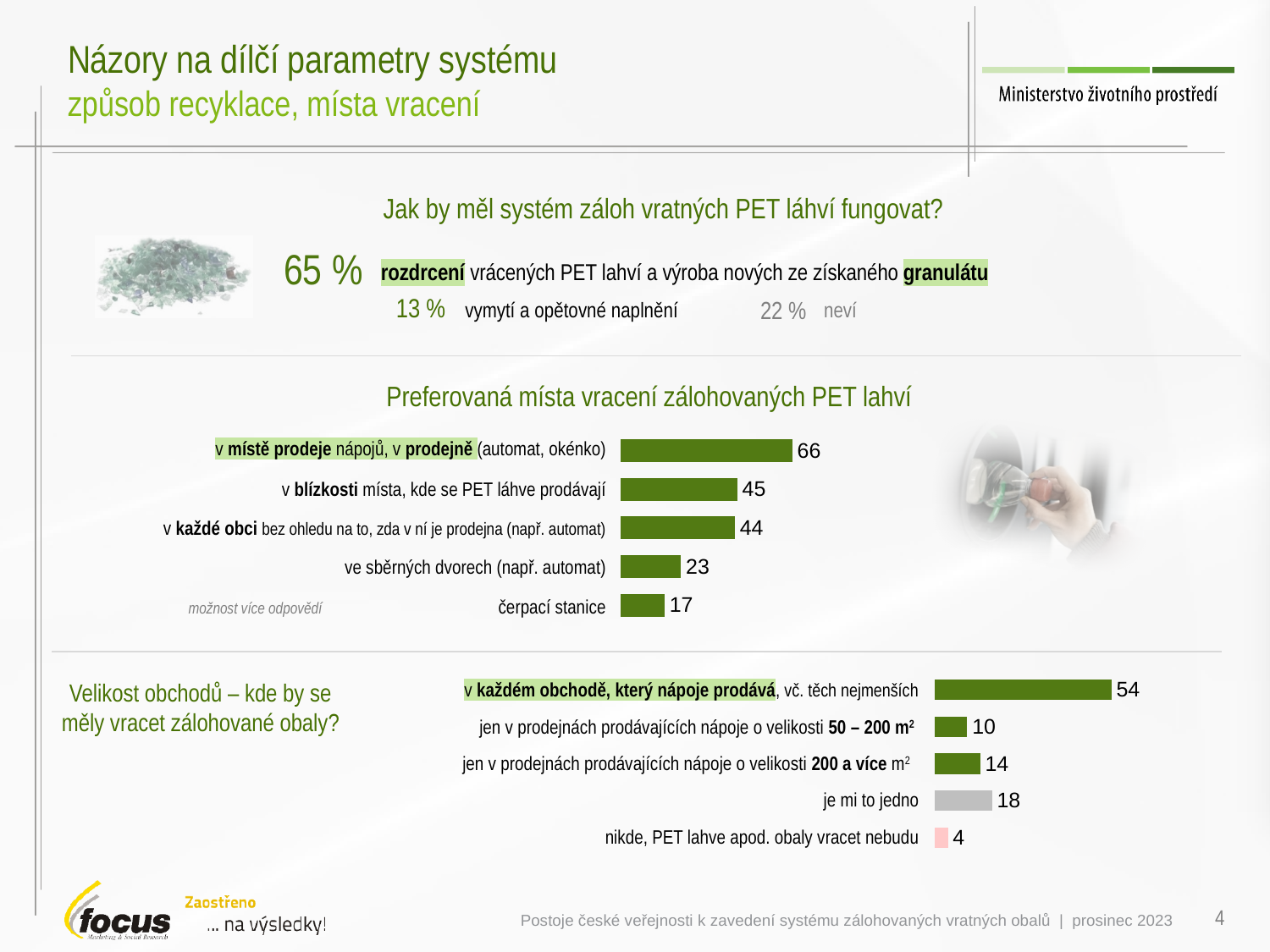
In the chart 'Velikost obchodů – kde by se měly vracet zálohované obaly?', how many categories are shown? 5 In the chart 'Preferovaná místa vracení zálohovaných PET lahví', which category has the lowest value? čerpací stanice In the chart 'Preferovaná místa vracení zálohovaných PET lahví', which category has the highest value? v místě prodeje nápojů, v prodejně (automat, okénko) What kind of chart is 'Preferovaná místa vracení zálohovaných PET lahví'? bar chart In the chart 'Velikost obchodů – kde by se měly vracet zálohované obaly?', what is the value for 'je mi to jedno'? 18 In the chart 'Velikost obchodů – kde by se měly vracet zálohované obaly?', which category has the lowest value? nikde, PET lahve apod. obaly vracet nebudu In the chart 'Velikost obchodů – kde by se měly vracet zálohované obaly?', what is the value for 'v každém obchodě, který nápoje prodává, vč. těch nejmenších'? 54 In the chart 'Velikost obchodů – kde by se měly vracet zálohované obaly?', what is the difference between the values for 'v každém obchodě, který nápoje prodává' and 'je mi to jedno'? 36 In the chart 'Preferovaná místa vracení zálohovaných PET lahví', what is the value for 'čerpací stanice'? 17 In the chart 'Velikost obchodů – kde by se měly vracet zálohované obaly?', which is larger: the value for 'jen v prodejnách prodávajících nápoje o velikosti 50 – 200 m²' or for 'jen v prodejnách prodávajících nápoje o velikosti 200 a více m²'? jen v prodejnách prodávajících nápoje o velikosti 200 a více m² In the chart 'Preferovaná místa vracení zálohovaných PET lahví', what is the difference between the values for 'v místě prodeje nápojů, v prodejně' and 've sběrných dvorech'? 43 In the chart 'Preferovaná místa vracení zálohovaných PET lahví', how many categories are shown? 5